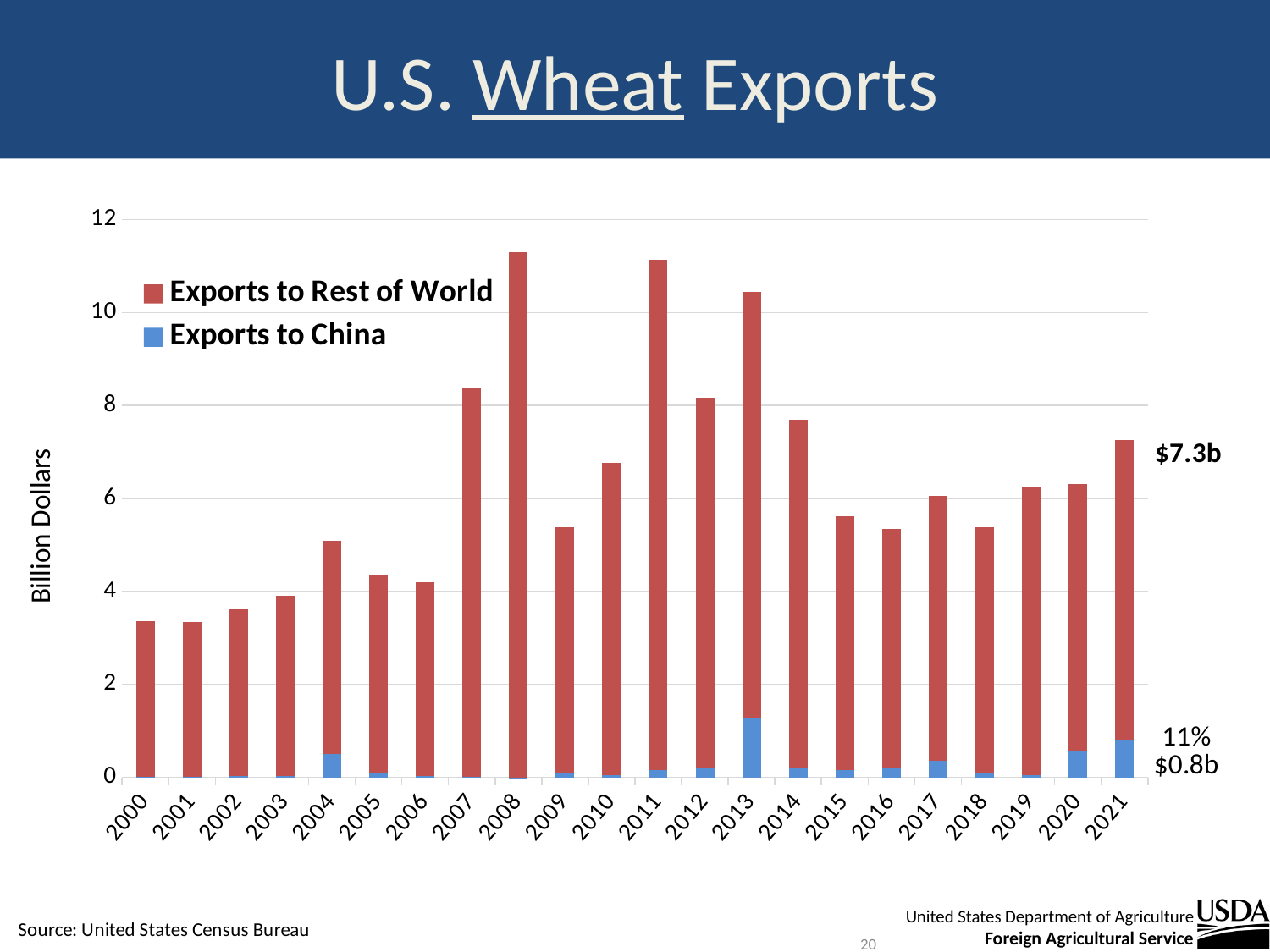
How many series does the legend list? 2 How many years are shown on the x axis? 22 In which year were exports to China the highest? 2013 Do total wheat exports rise or fall from 2000 to 2004? Rise What share of 2021 wheat exports went to China, according to the label on the chart? 11% What kind of chart is shown on the slide? Stacked bar chart Is the total value for 2016 greater or less than 6? less Is the total value for 2007 greater or less than 8? greater What is the value of exports to China labelled for 2021? $0.8b What is the total value of U.S. wheat exports labelled for 2021? $7.3b Which year has the larger total exports, 2012 or 2014? 2012 What is the label on the y axis? Billion Dollars